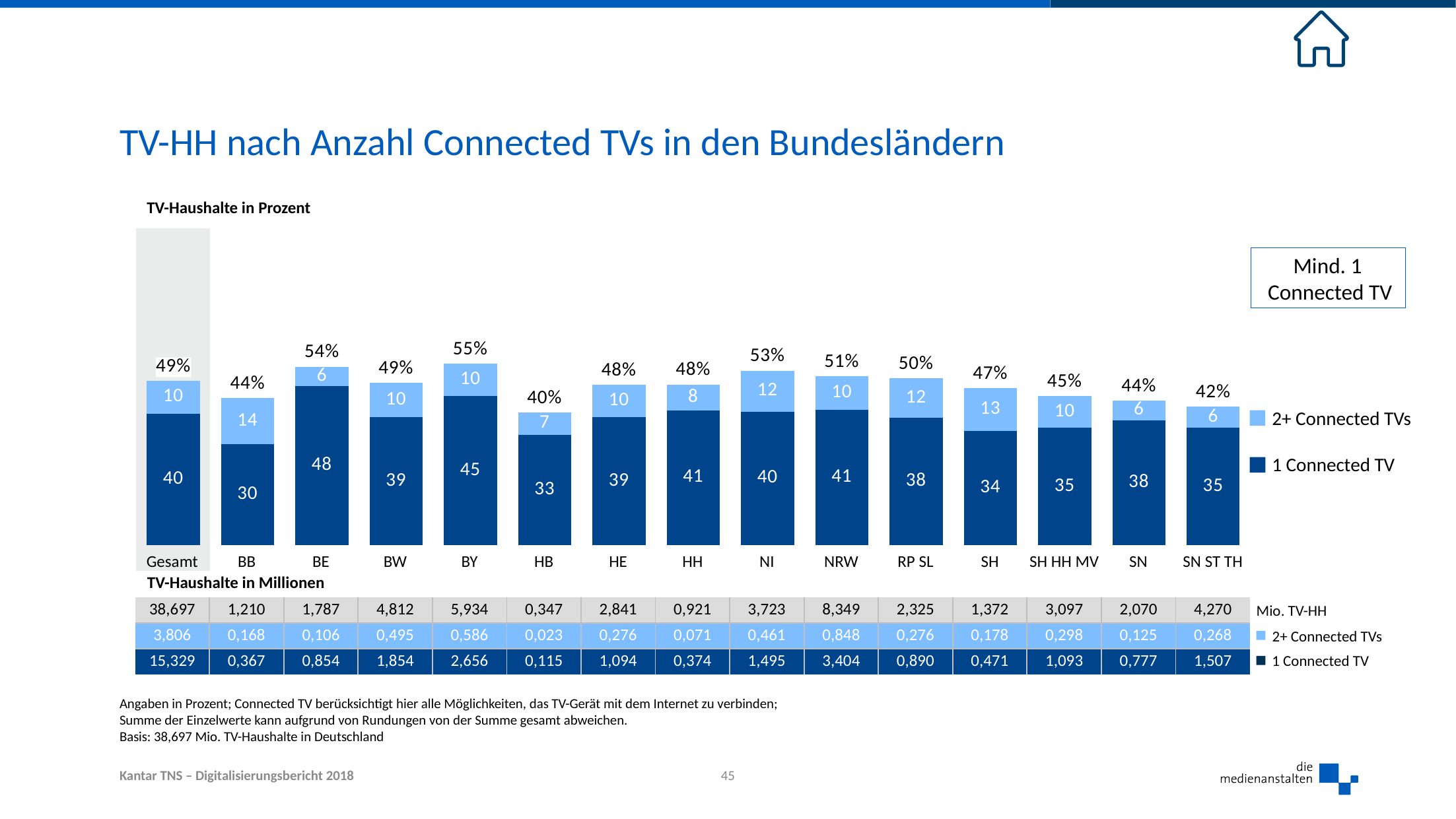
How many series does the chart legend list? 2 What is the value for 2+ Connected TVs in BB? 14 What is the value for 1 Connected TV in BE? 48 What are the two legend entries of the chart? 2+ Connected TVs and 1 Connected TV What is the total percentage shown above the stacked bar for BY? 55% Which category has the lowest total share of households with at least one Connected TV? HB How many categories are shown on the x axis of the chart? 15 What kind of chart is shown on the slide? Stacked bar chart Which has the larger 1 Connected TV value, NRW or RP SL? NRW Which category has the highest total share of households with at least one Connected TV? BY What is the value for 2+ Connected TVs for Gesamt? 10 What is the difference between the 1 Connected TV values for BE and BB? 18